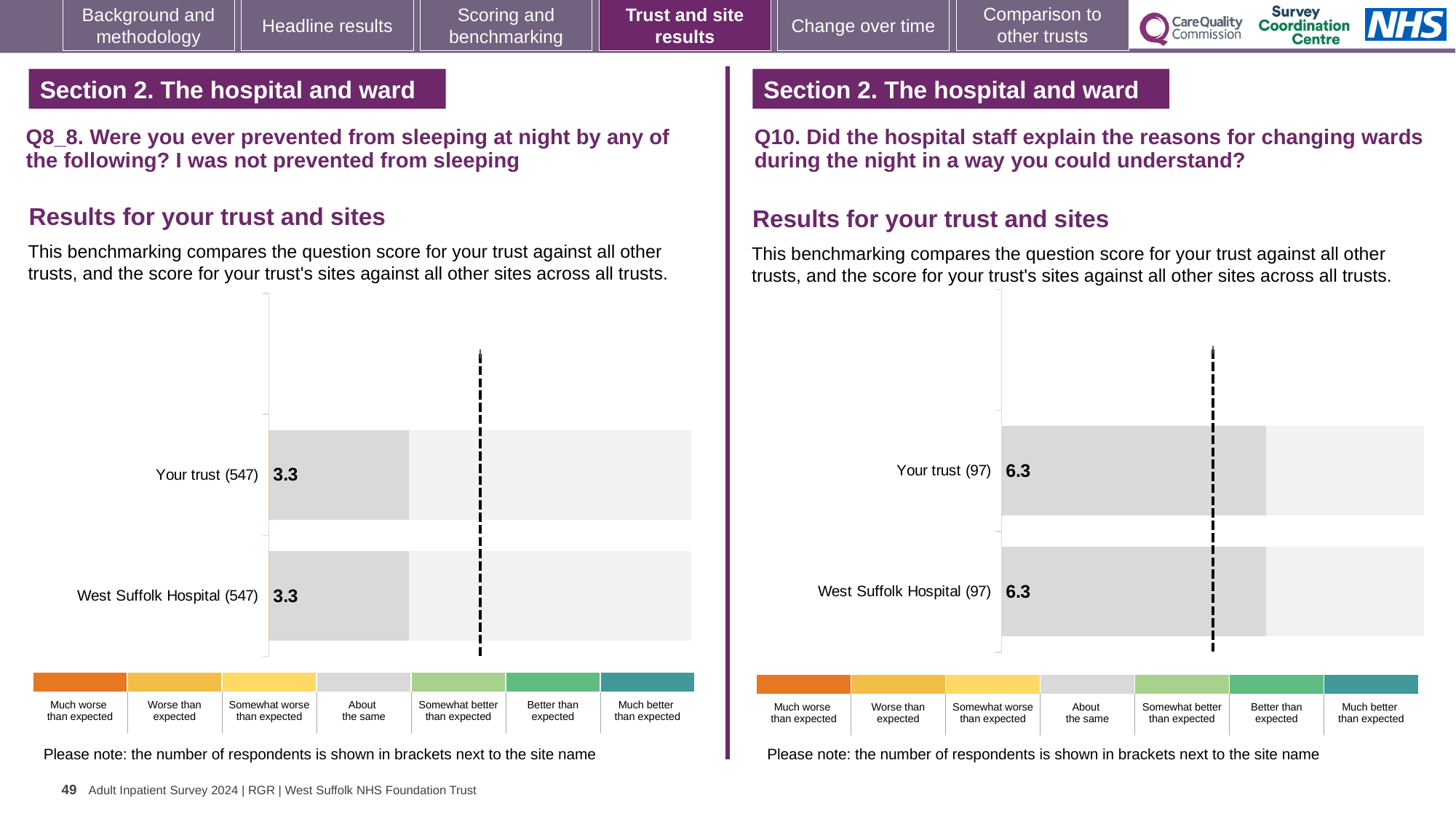
Is the Your trust score on the right chart (Q10) larger or smaller than the Your trust score on the left chart (Q8_8)? Larger On the left chart (Q8_8), what is the score for Your trust? 3.3 On the right chart (Q10), what is the score for West Suffolk Hospital? 6.3 On the left chart (Q8_8), what is the score for West Suffolk Hospital? 3.3 On the right chart (Q10), how many respondents are shown in brackets for West Suffolk Hospital? 97 On the left chart (Q8_8), how many respondents are shown in brackets for Your trust? 547 On the left chart (Q8_8), what is the difference between the Your trust score and the West Suffolk Hospital score? 0 On the right chart (Q10), what is the score for Your trust? 6.3 On the right chart (Q10), what is the difference between the Your trust score and the West Suffolk Hospital score? 0 How many bars are plotted on the left chart (Q8_8)? 2 What kind of chart is used on the left (Q8_8)? Bar chart How many bars are plotted on the right chart (Q10)? 2